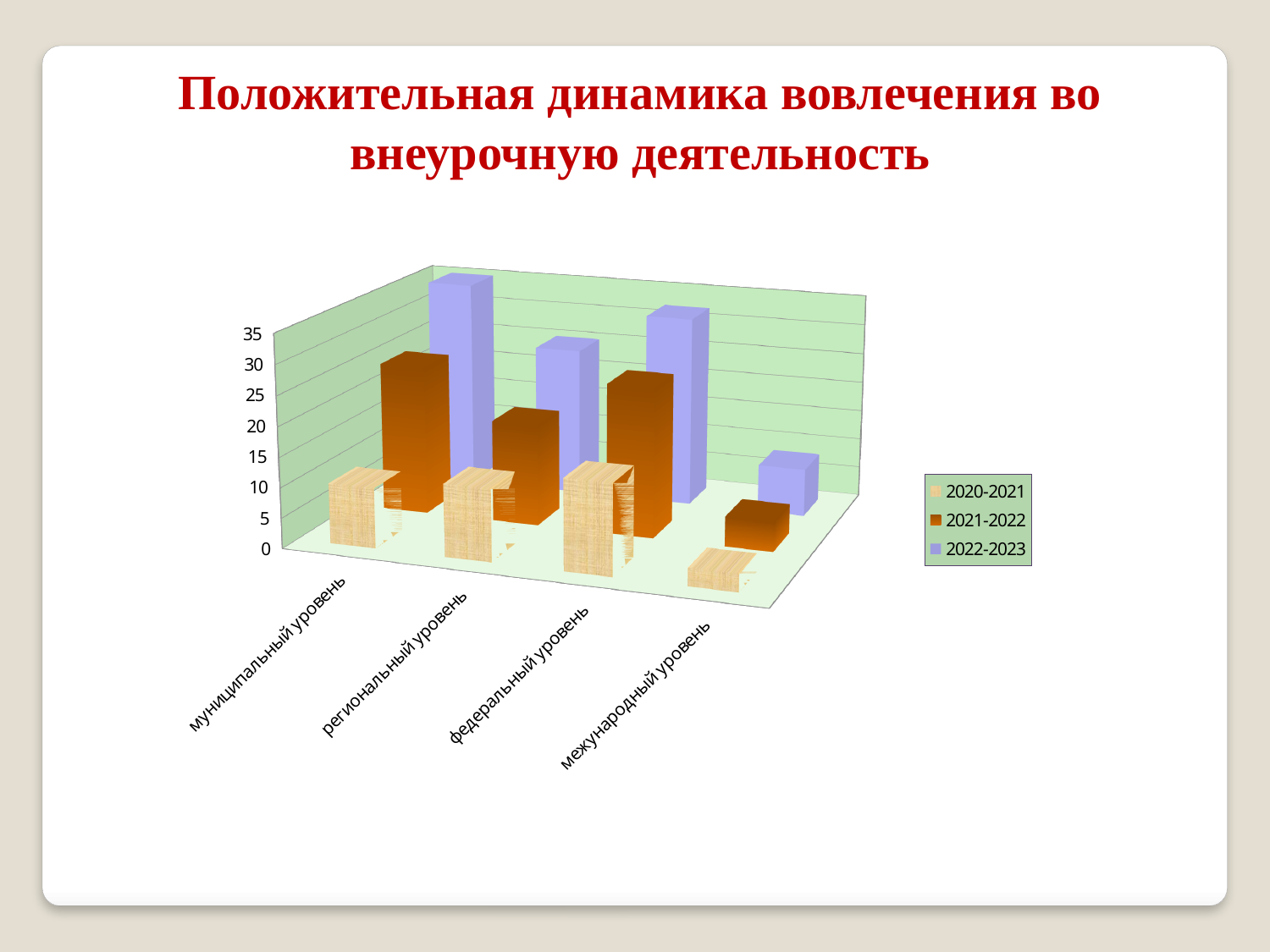
Which series is shown in purple in the chart? 2022-2023 Is the 2021-2022 value for муниципальный уровень greater or less than 20? greater How many series does the legend list? 3 What kind of chart is shown on the slide? bar chart For which category is the 2022-2023 value the lowest? межународный уровень For международный уровень, which is larger: the 2020-2021 value or the 2022-2023 value? 2022-2023 What is the title of the slide containing the chart? Положительная динамика вовлечения во внеурочную деятельность For муниципальный уровень, which is larger: the 2020-2021 value or the 2022-2023 value? 2022-2023 For which category is the 2021-2022 value the lowest? межународный уровень How many categories are shown on the x axis of the chart? 4 Is the 2022-2023 value for международный уровень greater or less than 15? less For which category is the 2022-2023 value the highest? муниципальный уровень